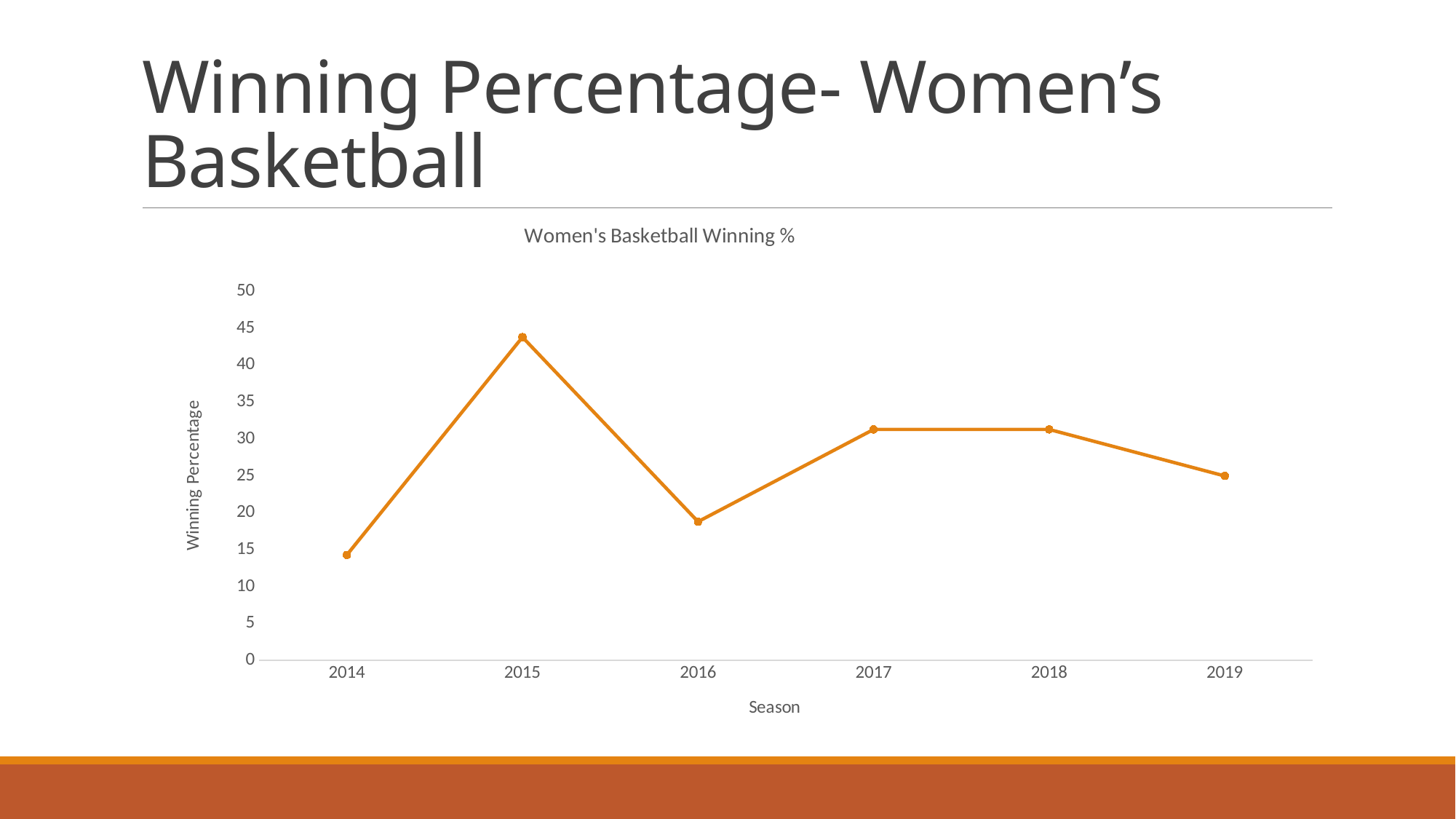
How many seasons are plotted on the x axis? 6 Is the winning percentage for 2016 greater or less than 20? less Does the winning percentage rise or fall from 2018 to 2019? fall Which season has the highest winning percentage? 2015 What is the title of the chart? Women's Basketball Winning % Is the winning percentage for 2015 greater or less than 40? greater Is the winning percentage for 2017 greater or less than 30? greater Which season has the lowest winning percentage? 2014 What kind of chart is shown on the slide? line chart Which season has a higher winning percentage, 2016 or 2019? 2019 What is the label on the y axis? Winning Percentage